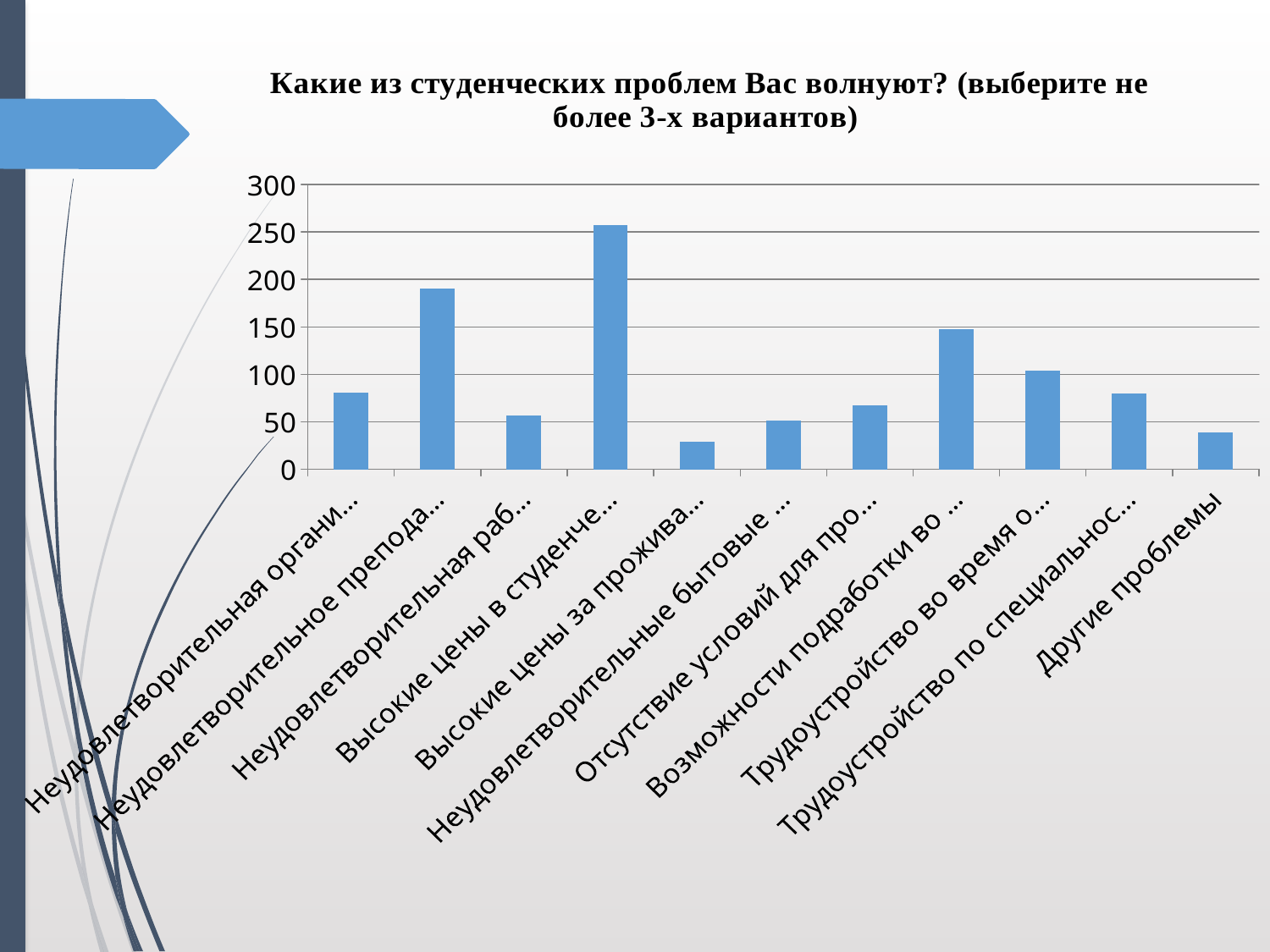
Is the value for the first bar, "Неудовлетворительная органи...", greater or less than 50? greater Which category has the highest bar? Высокие цены в студенче... What kind of chart is shown on the slide? bar chart How many categories (bars) are plotted in the chart? 11 Is the value for "Неудовлетворительное препода..." greater or less than 150? greater Is the value for "Высокие цены за прожива..." greater or less than 50? less Which category has the lowest bar? Высокие цены за прожива... Which is larger: the value for "Трудоустройство во время о..." or the value for "Другие проблемы"? Трудоустройство во время о... Which is larger: the value for "Неудовлетворительное препода..." or the value for "Возможности подработки во ..."? Неудовлетворительное препода... What is the title of the chart? Какие из студенческих проблем Вас волнуют? (выберите не более 3-х вариантов)